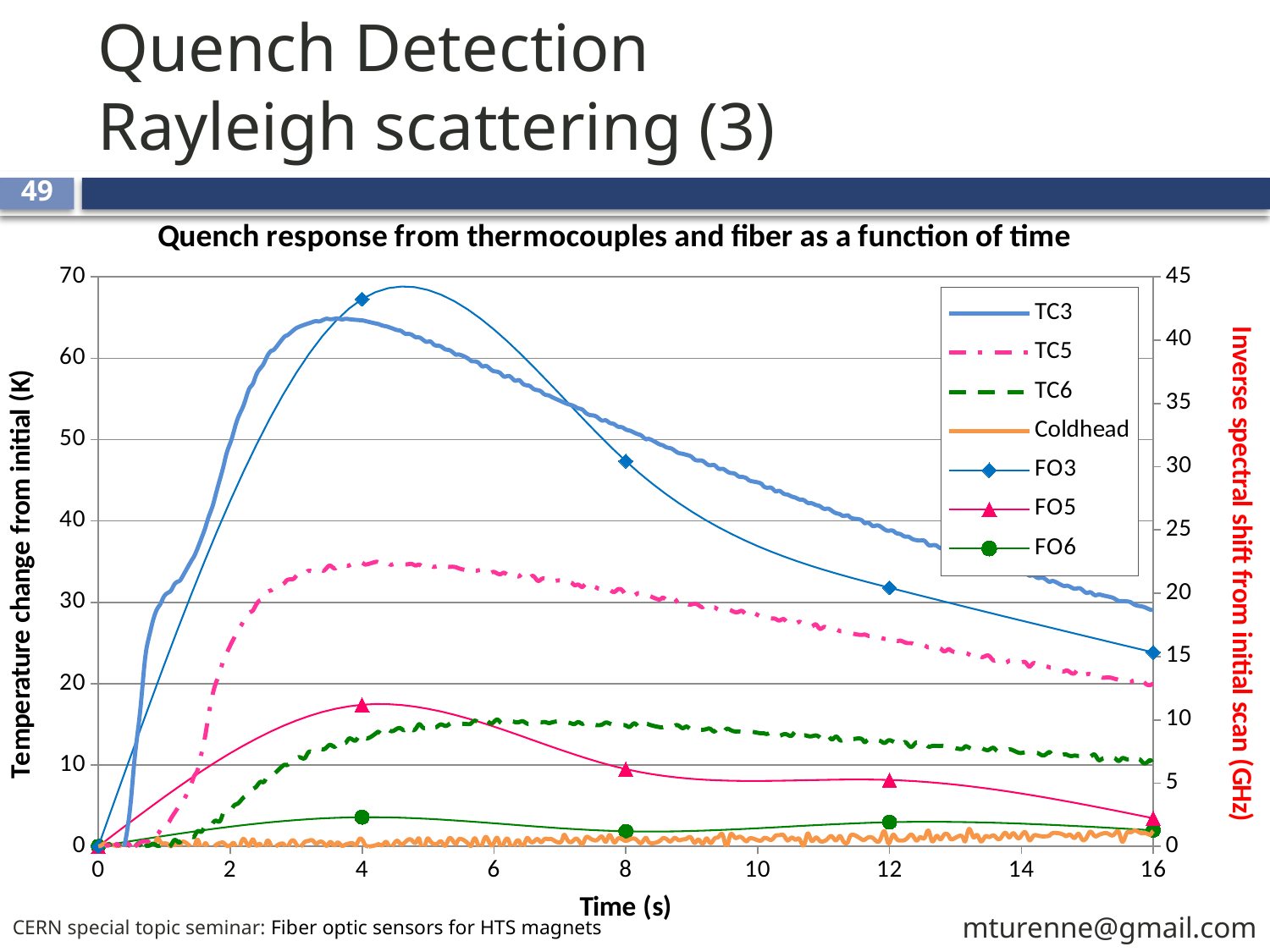
Is the TC5 value at time 4 s greater or less than 30 on the left axis? greater At time 8 s, which is higher, TC3 or TC5? TC3 Does the TC3 series rise or fall between time 4 s and 16 s? fall Which of the thermocouple series (TC3, TC5, TC6) reaches the highest peak? TC3 What kind of chart is shown on the slide? line chart Is the TC3 value at time 4 s greater or less than 60 on the left axis? greater Is the TC6 value at time 8 s greater or less than 20 on the left axis? less Which series stays lowest across the whole time range? Coldhead How many series does the legend list? 7 What is the title of the chart? Quench response from thermocouples and fiber as a function of time What is the label of the right-hand vertical axis? Inverse spectral shift from initial scan (GHz)